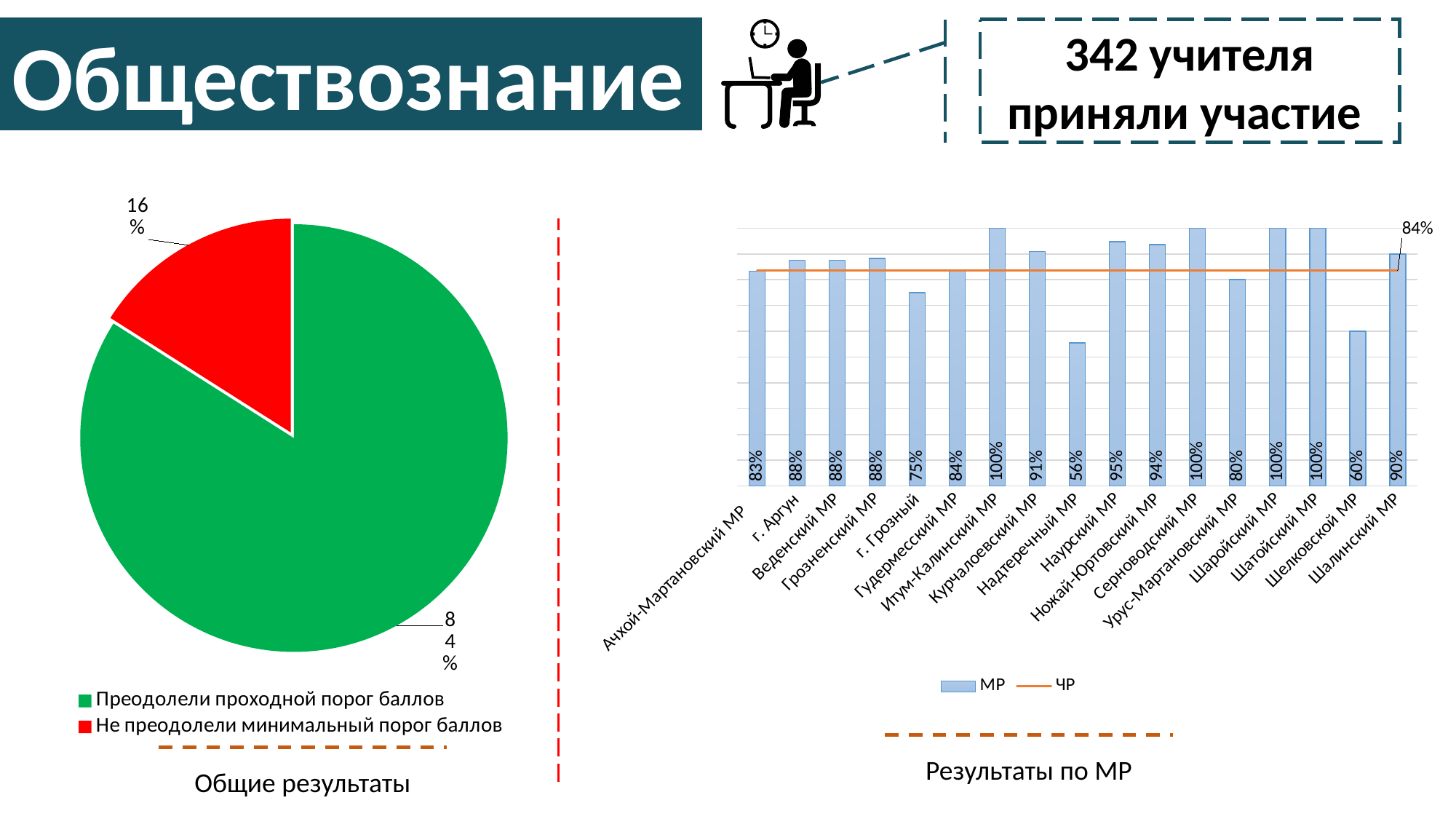
On the bar chart on the right ('Результаты по МР'), what value is labelled on the ЧР line? 84% On the pie chart on the left, which slice is larger: 'Преодолели проходной порог баллов' or 'Не преодолели минимальный порог баллов'? Преодолели проходной порог баллов On the bar chart on the right ('Результаты по МР'), what is the value for Курчалоевский МР? 91% On the bar chart on the right ('Результаты по МР'), how many series does the legend list? 2 On the pie chart on the left, what colour is the slice for 'Не преодолели минимальный порог баллов'? Red On the bar chart on the right ('Результаты по МР'), which district has the lowest value? Надтеречный МР On the bar chart on the right ('Результаты по МР'), what is the difference between the values for Наурский МР and Шелковской МР? 35% On the pie chart on the left, what share is labelled 'Не преодолели минимальный порог баллов'? 16% On the bar chart on the right ('Результаты по МР'), how many districts are shown on the x axis? 17 On the pie chart on the left, what share of teachers is labelled 'Преодолели проходной порог баллов'? 84% On the bar chart on the right ('Результаты по МР'), what is the value for Надтеречный МР? 56% On the bar chart on the right ('Результаты по МР'), which is larger: the value for г. Грозный or the value for Урус-Мартановский МР? Урус-Мартановский МР